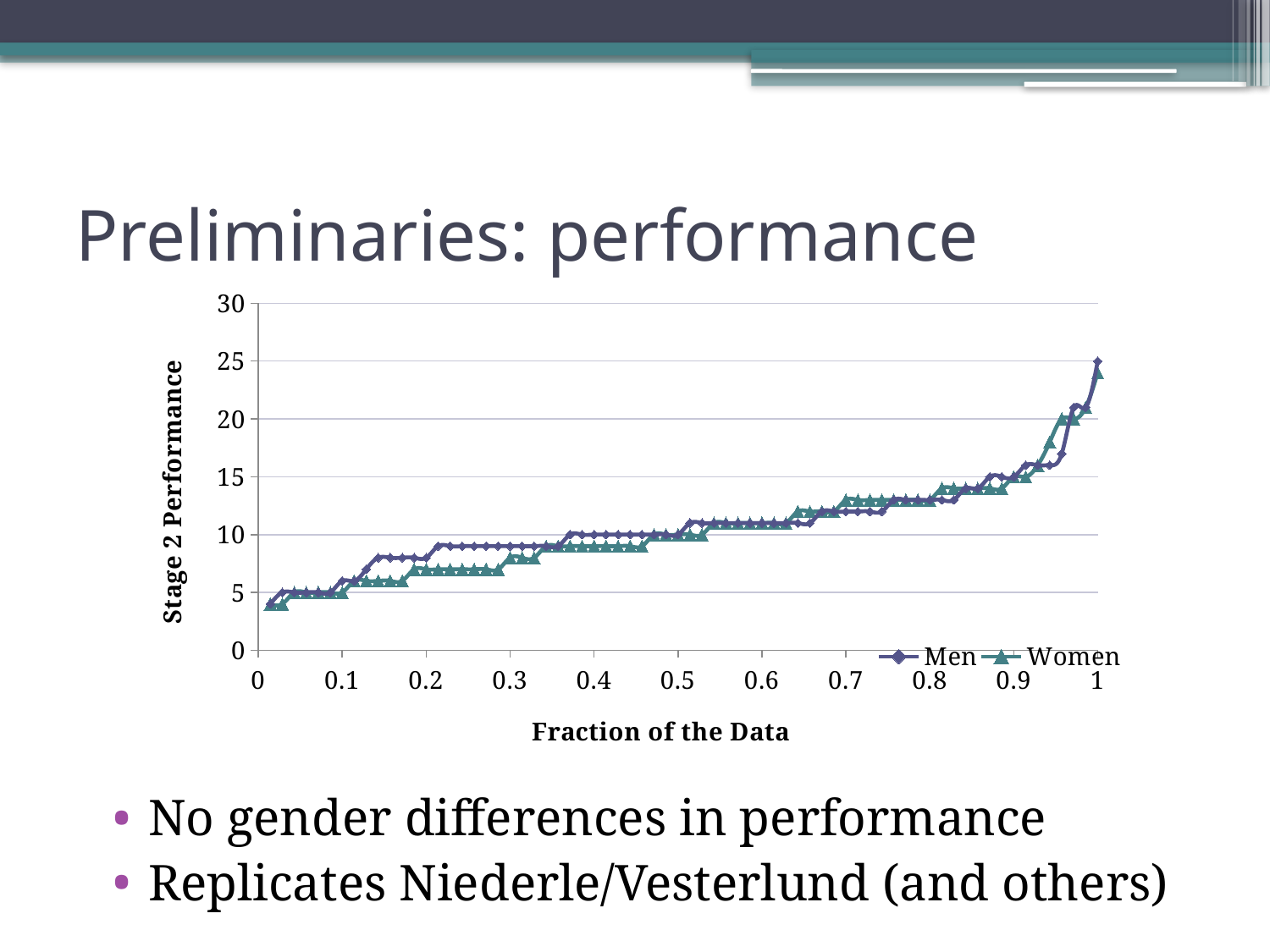
Is the value for Men at a fraction of 1 greater or less than 20? greater What kind of chart is shown on the slide? line chart What is the title of the vertical axis? Stage 2 Performance Is the value for Women at a fraction of 1 greater or less than 20? greater Is the value for Men at a fraction of 0.9 greater or less than 10? greater What are the two series named in the legend? Men and Women Do the values for Women rise or fall along the x axis? rise Do the values for Men rise or fall as the fraction of the data increases from 0 to 1? rise How many series does the legend list? 2 At a fraction of 0.2, which series has the higher value, Men or Women? Men